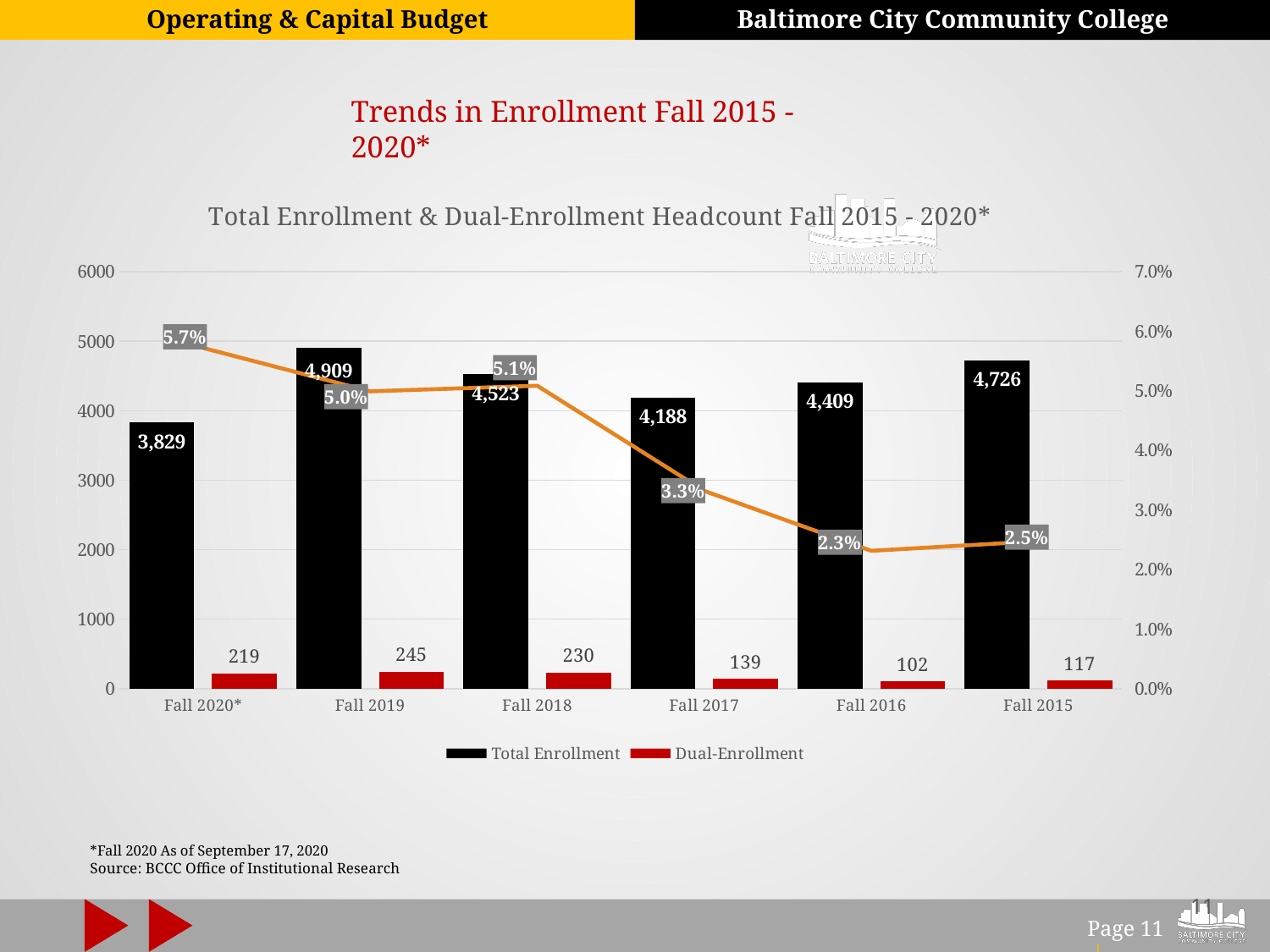
Which is larger, Total Enrollment in Fall 2018 or in Fall 2016? Fall 2018 What is the Dual-Enrollment value for Fall 2016? 102 How many series does the legend list? 2 Which term has the highest Total Enrollment? Fall 2019 What percentage is labelled on the line for Fall 2017? 3.3% What is the difference between Dual-Enrollment in Fall 2019 and Fall 2018? 15 What is the title of the chart? Total Enrollment & Dual-Enrollment Headcount Fall 2015 - 2020* What is the Total Enrollment value for Fall 2019? 4,909 What is the difference between Total Enrollment in Fall 2015 and Fall 2020*? 897 Which term has the lowest Dual-Enrollment headcount? Fall 2016 How many terms are shown on the x axis? 6 What kind of chart is used for the Total Enrollment and Dual-Enrollment series? Bar chart